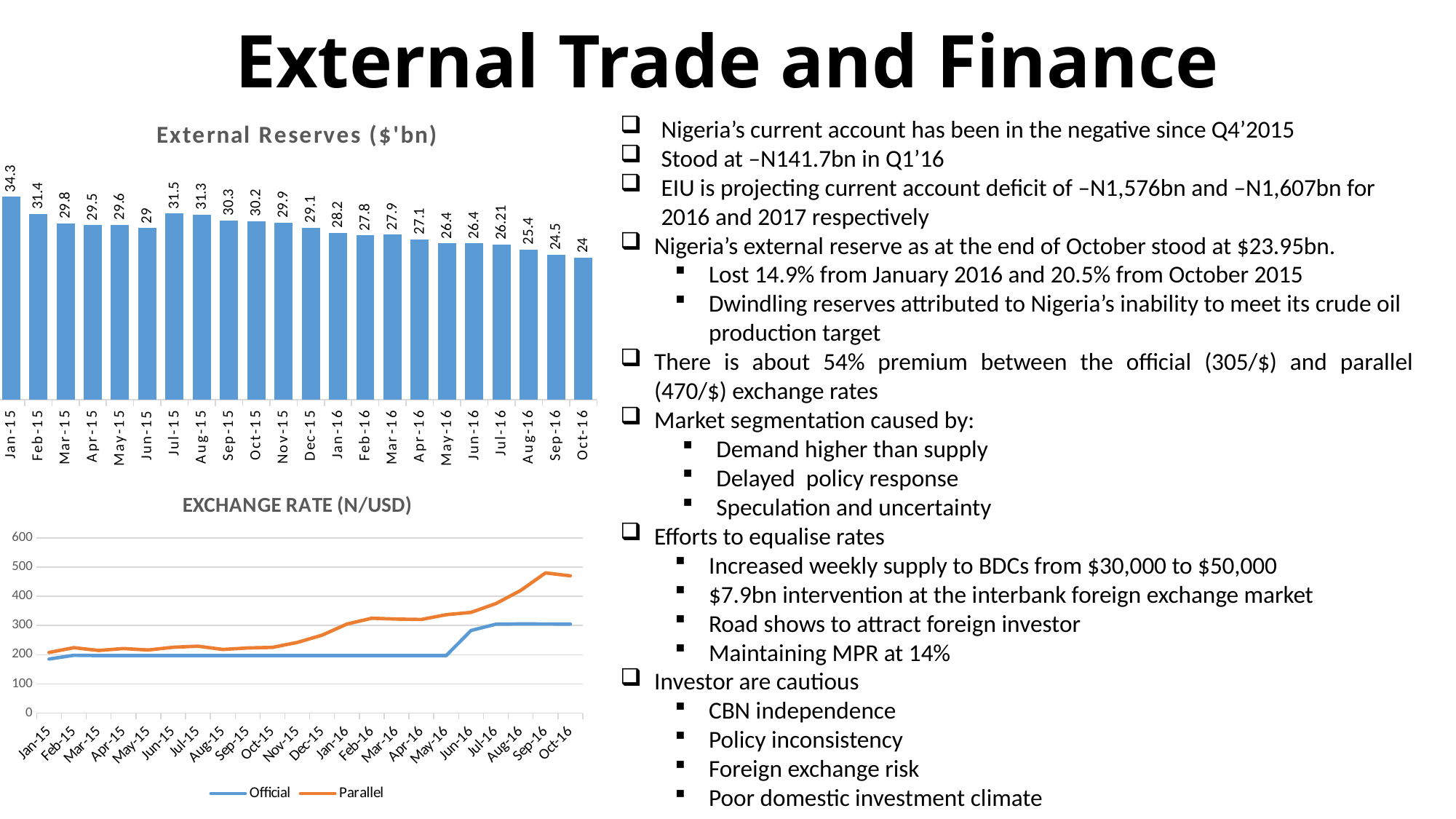
In the EXCHANGE RATE (N/USD) chart, is the Parallel value for Sep-16 greater or less than 400? greater In the EXCHANGE RATE (N/USD) chart, is the Official value for Jan-16 greater or less than 300? less In the External Reserves ($'bn) chart, which is larger, the value for Jul-15 or the value for Dec-15? Jul-15 In the External Reserves ($'bn) chart, what is the difference between the values for Jan-15 and Oct-16? 10.3 How many series does the legend of the EXCHANGE RATE (N/USD) chart list? 2 In the External Reserves ($'bn) chart, what is the value for Oct-16? 24 What kind of chart is the External Reserves ($'bn) chart? Bar chart In the External Reserves ($'bn) chart, what is the value for Jul-16? 26.21 In the External Reserves ($'bn) chart, which month has the highest value? Jan-15 How many months are shown in the External Reserves ($'bn) chart? 22 In the External Reserves ($'bn) chart, which month has the lowest value? Oct-16 In the External Reserves ($'bn) chart, what is the value for Jan-15? 34.3